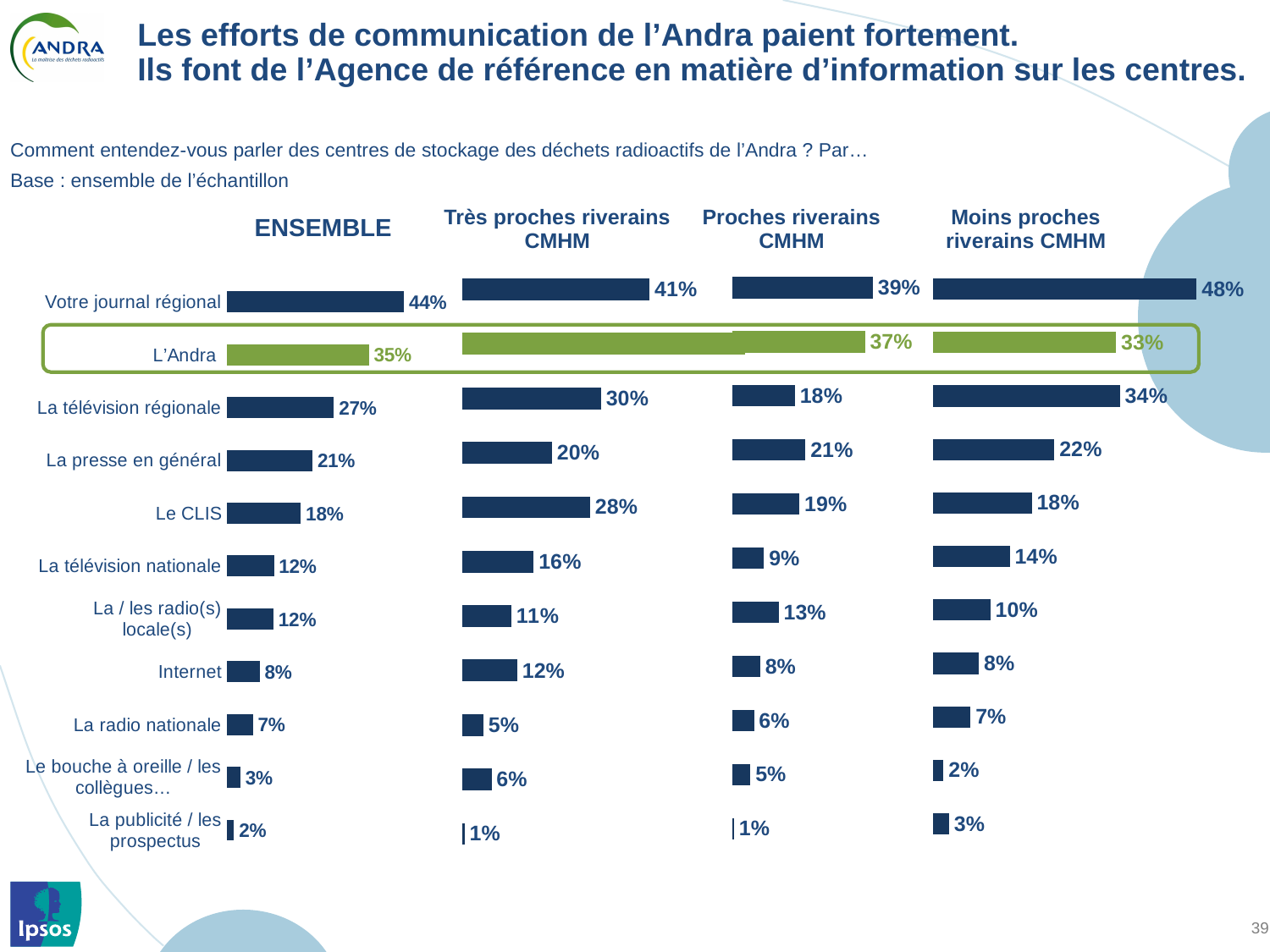
In the ENSEMBLE chart, what is the difference between Votre journal régional and L'Andra? 9% In the Proches riverains CMHM chart, what is the value for La télévision régionale? 18% In the Très proches riverains CMHM chart, what is the value for Le CLIS? 28% How many categories are shown in the ENSEMBLE chart? 11 Which category is highlighted in green across the charts? L'Andra In the ENSEMBLE chart, which category has the highest value? Votre journal régional In the Moins proches riverains CMHM chart, what is the value for Votre journal régional? 48% In the ENSEMBLE chart, what is the value for L'Andra? 35% In the ENSEMBLE chart, which category has the lowest value? La publicité / les prospectus In the Proches riverains CMHM chart, what is the value for La / les radio(s) locale(s)? 13% What kind of chart is used on this slide? Bar chart In the Moins proches riverains CMHM chart, which is larger: La télévision régionale or L'Andra? La télévision régionale